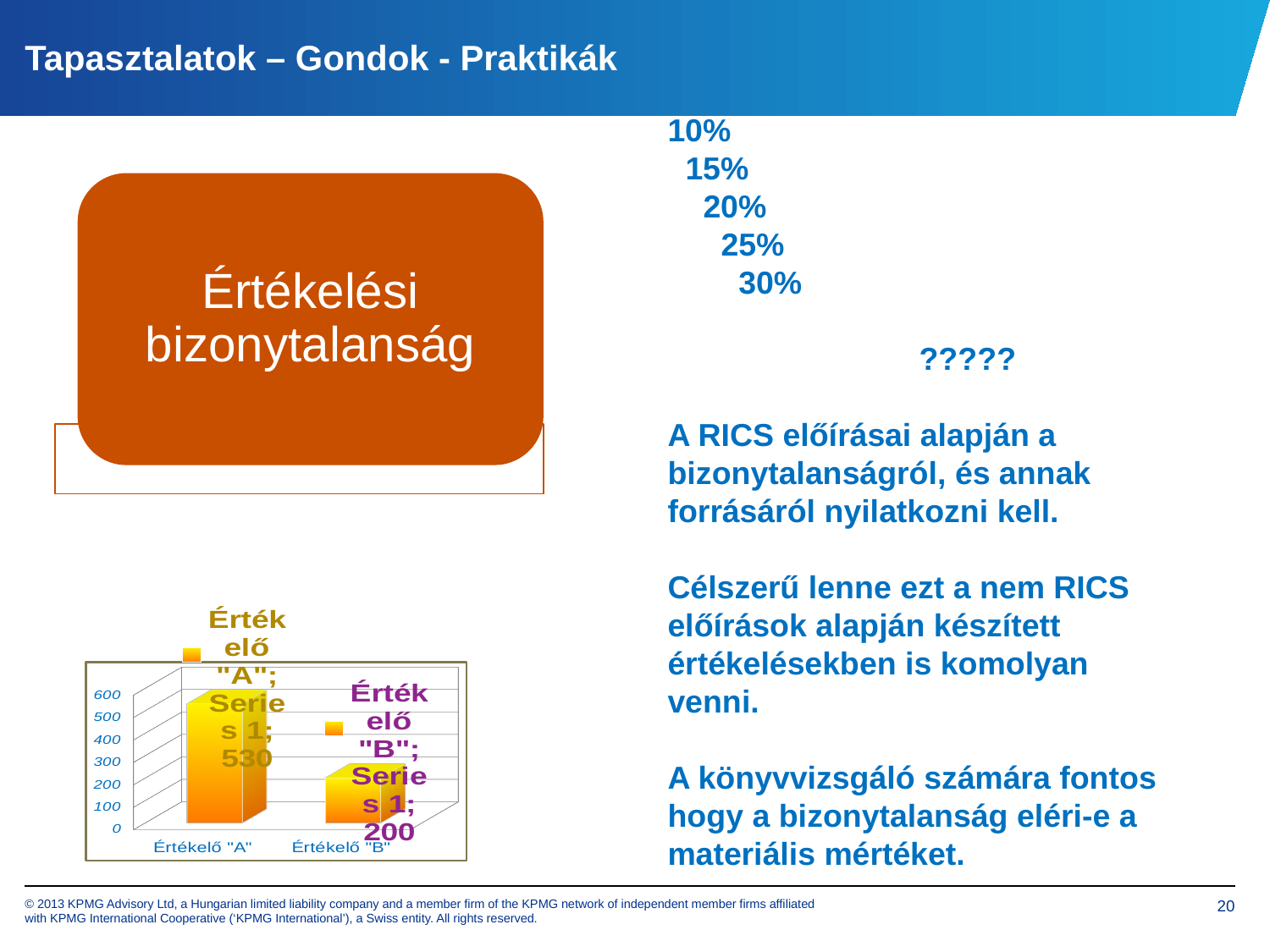
What is the difference between the values for Értékelő "A" and Értékelő "B"? 330 Is the value for Értékelő "A" greater or less than 500? greater What is the highest tick value shown on the vertical axis of the bar chart? 600 Is the value for Értékelő "B" greater or less than 300? less What is the value for Értékelő "A" in the bar chart? 530 What is the value for Értékelő "B" in the bar chart? 200 What kind of chart is shown on the slide? bar chart Which category has the highest value in the bar chart? Értékelő "A" Do the values rise or fall from Értékelő "A" to Értékelő "B"? fall How many categories are shown on the x axis of the bar chart? 2 Which category has the lowest value in the bar chart? Értékelő "B" Which is larger, the value for Értékelő "A" or the value for Értékelő "B"? Értékelő "A"